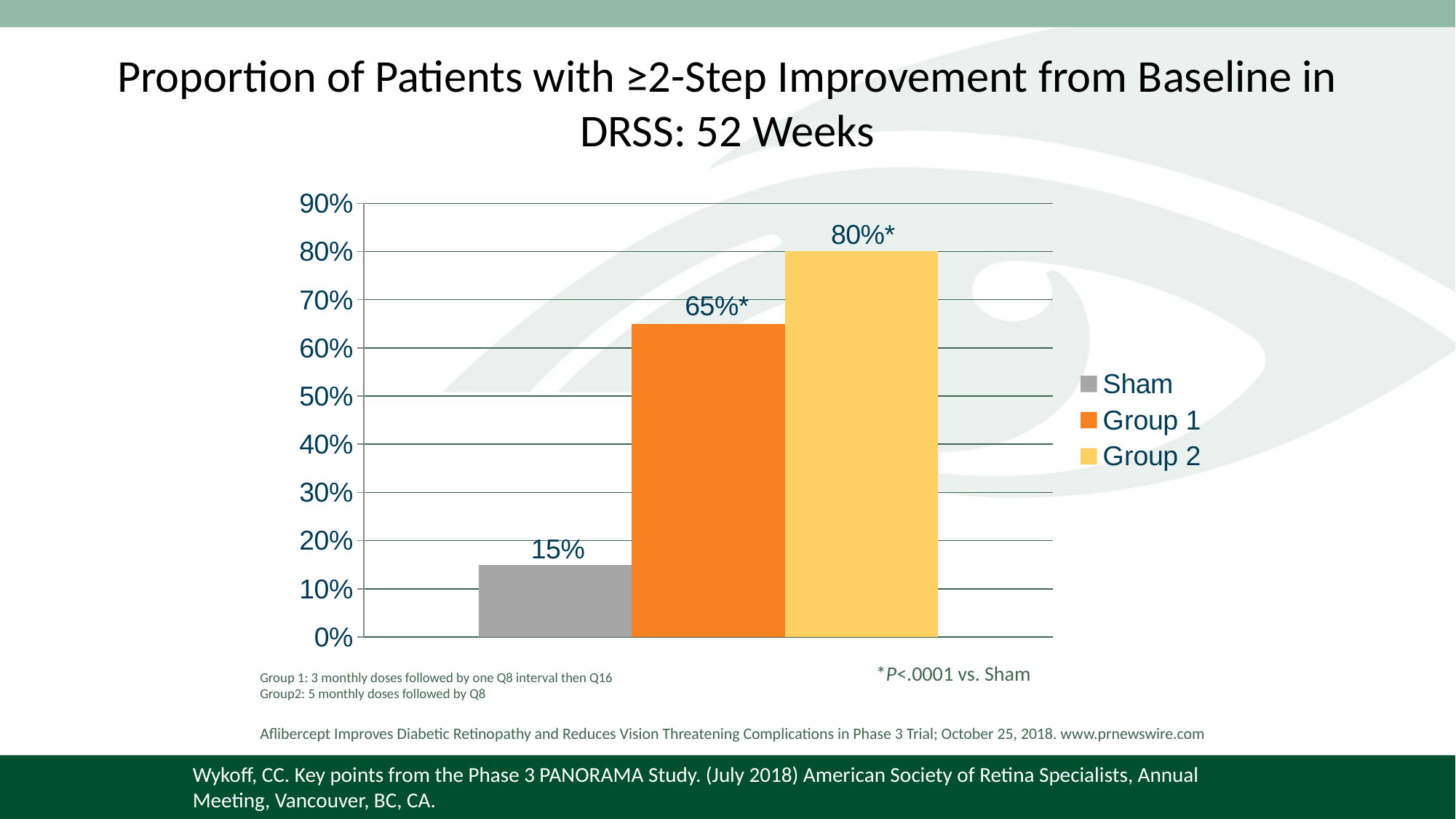
What is the difference between the Group 2 value and the Group 1 value? 15% What is the value shown for Sham? 15% What is the difference between the Group 1 value and the Sham value? 50% Which series has the highest value? Group 2 Which series has the lowest value? Sham What colour is the bar for Group 1? orange What is the value shown for Group 1? 65%* How many series does the legend list? 3 What kind of chart is shown on the slide? bar chart What is the value shown for Group 2? 80%* Which is larger, the value for Group 1 or the value for Sham? Group 1 Is the value for Group 1 greater or less than 60%? greater